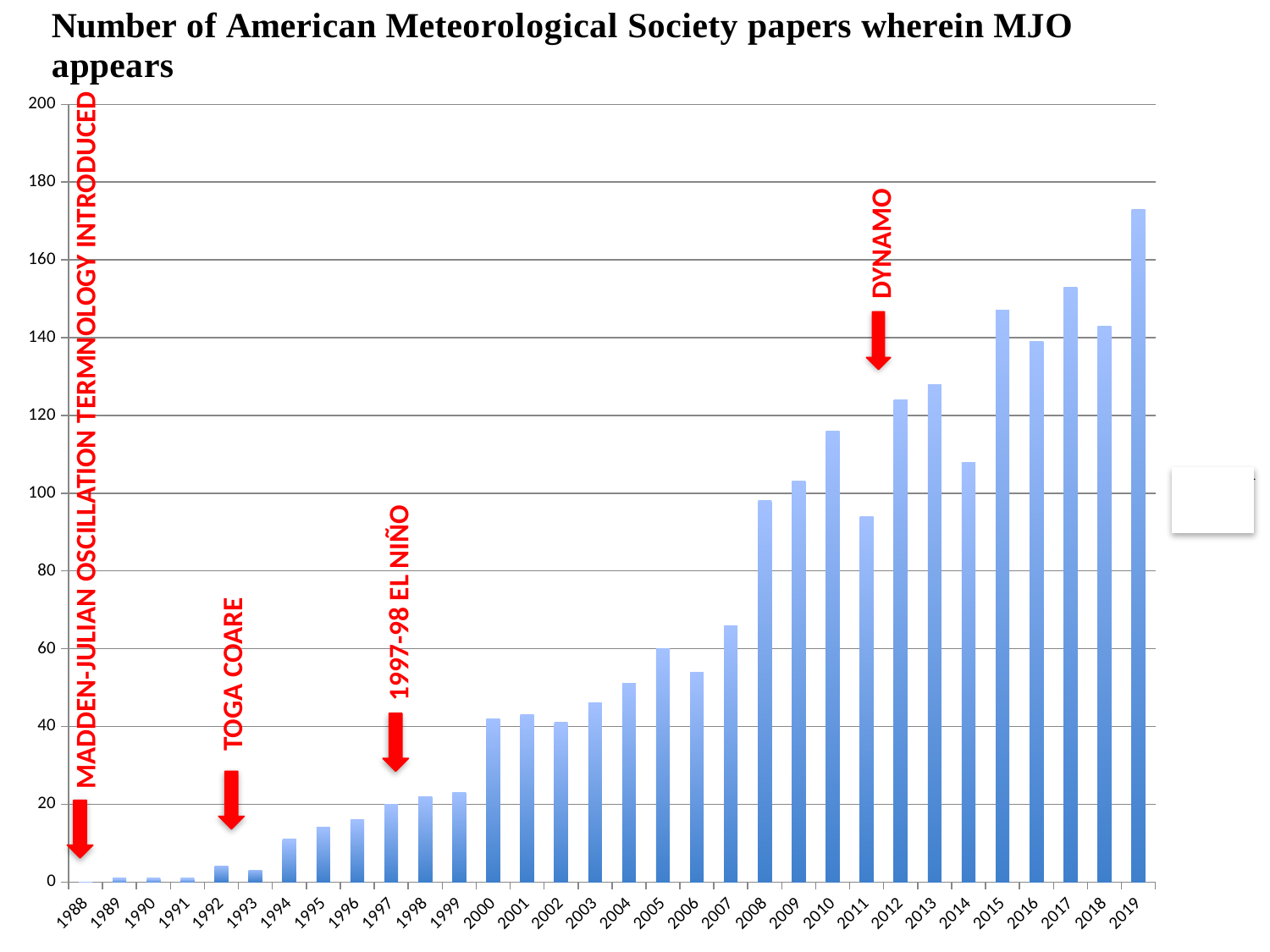
Which year has the highest number of papers? 2019 Overall, do the values rise or fall from 1988 to 2019? rise Which year has more papers, 2011 or 2012? 2012 Is the value for 2011 greater or less than 100? less What is the title of the chart? Number of American Meteorological Society papers wherein MJO appears How many years are shown along the x axis? 32 Is the value for 2019 greater or less than 160? greater What kind of chart is shown on the slide? bar chart Is the value for 2017 greater or less than 140? greater Which year has the lowest number of papers? 1988 Which year has more papers, 2014 or 2015? 2015